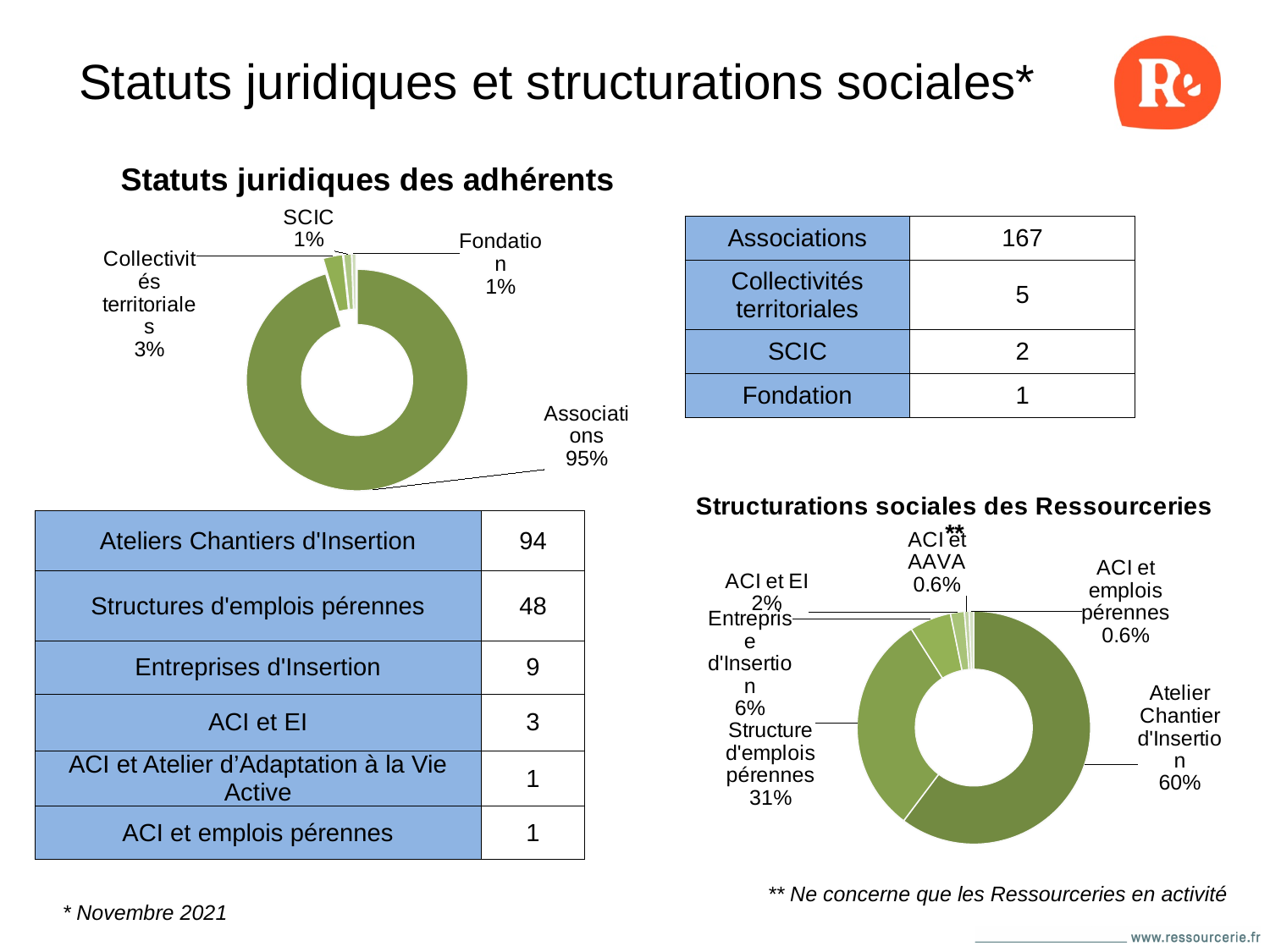
In the 'Structurations sociales des Ressourceries' chart, what share does Atelier Chantier d'Insertion have? 60% In the 'Structurations sociales des Ressourceries' chart, how many categories are shown? 6 In the 'Structurations sociales des Ressourceries' chart, what share does ACI et AAVA have? 0.6% In the 'Structurations sociales des Ressourceries' chart, what share does Structure d'emplois pérennes have? 31% In the 'Structurations sociales des Ressourceries' chart, what is the difference between the shares of Atelier Chantier d'Insertion and Structure d'emplois pérennes? 29% In the 'Structurations sociales des Ressourceries' chart, what share does Entreprise d'Insertion have? 6% In the 'Statuts juridiques des adhérents' chart, what share do Collectivités territoriales have? 3% In the 'Statuts juridiques des adhérents' chart, which category has the largest share? Associations In the 'Statuts juridiques des adhérents' chart, how many categories are shown? 4 What kind of chart is 'Statuts juridiques des adhérents'? Pie (doughnut) chart In the 'Statuts juridiques des adhérents' chart, what share do Associations have? 95% In the 'Structurations sociales des Ressourceries' chart, which category has the largest share? Atelier Chantier d'Insertion